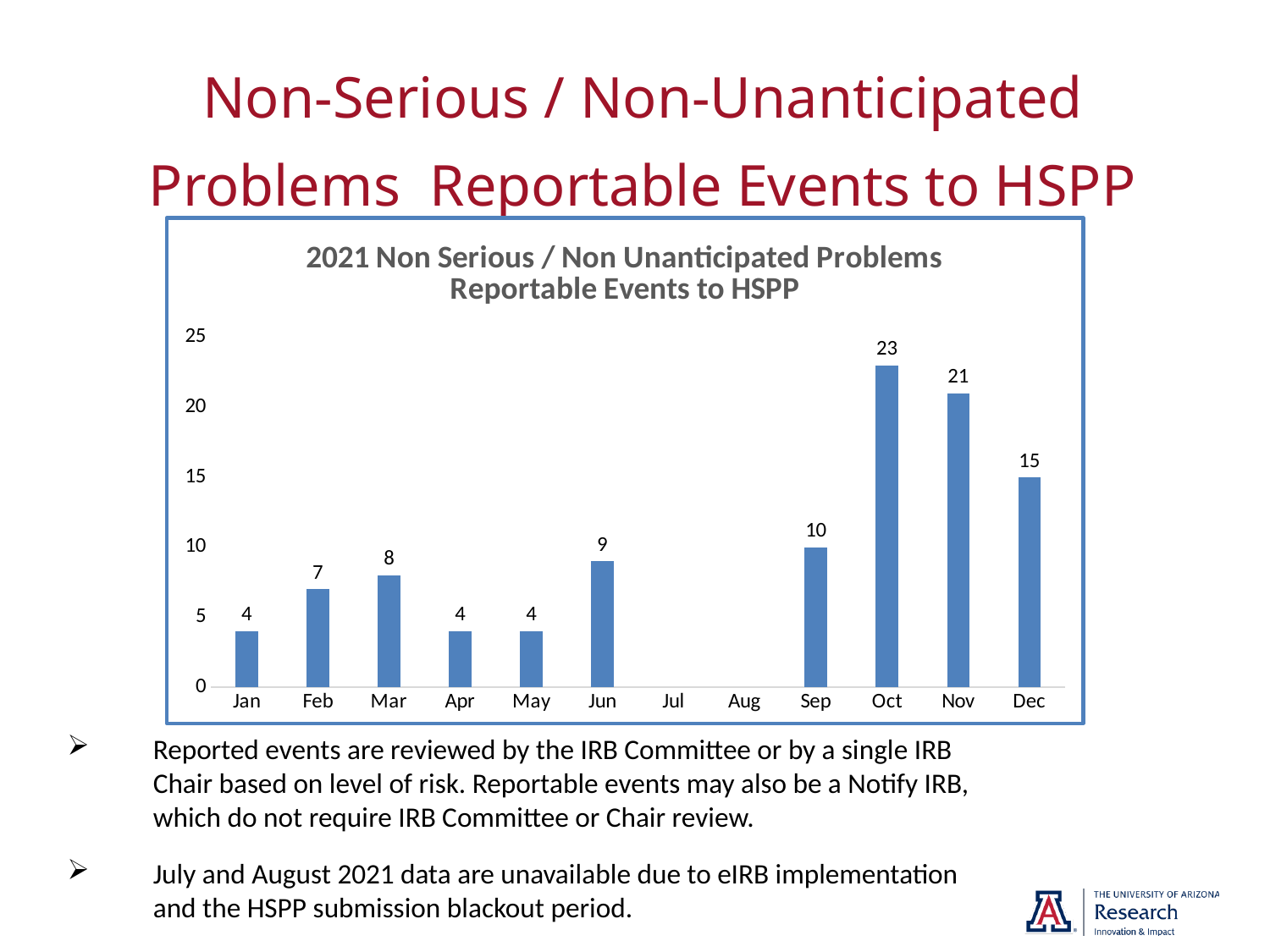
Is the value for Nov greater or less than 20? greater How many months are shown on the x axis? 12 What is the value for Dec? 15 What is the value for Oct? 23 Which is larger, the value for Mar or the value for Sep? Sep What is the difference between the values for Sep and Jun? 1 Which month has the highest value? Oct What is the value for Feb? 7 What kind of chart is shown? bar chart What is the title of the chart? 2021 Non Serious / Non Unanticipated Problems Reportable Events to HSPP What is the difference between the values for Oct and Nov? 2